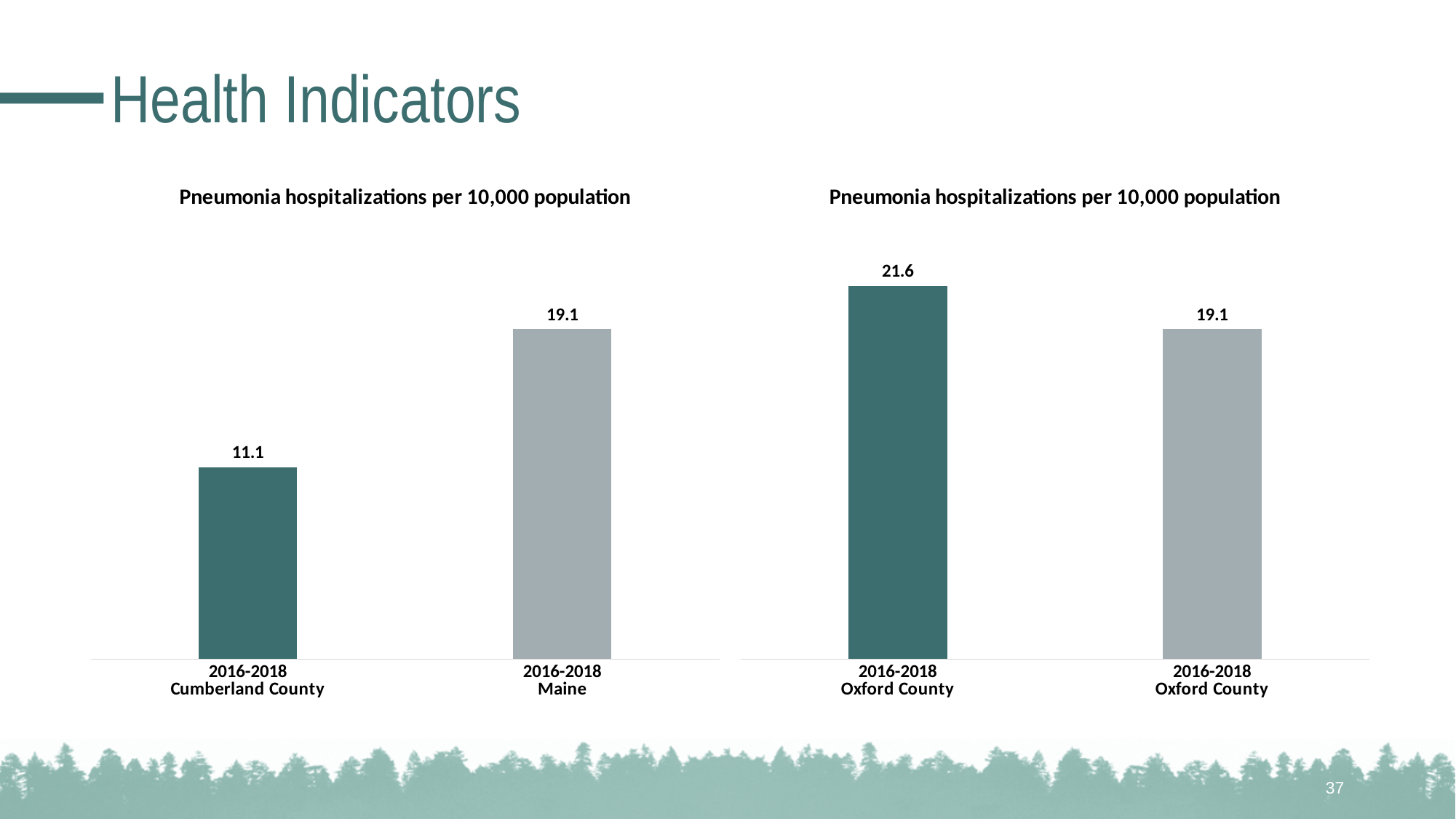
In the left chart, what is the value for 2016-2018 Cumberland County? 11.1 In the left chart, what is the difference between the Maine value and the Cumberland County value? 8.0 How many bars are plotted in the left chart? 2 In the right chart, what is the value of the dark teal bar on the left? 21.6 What is the title of the left chart? Pneumonia hospitalizations per 10,000 population In the left chart, which category has the lowest value? 2016-2018 Cumberland County In the right chart, what is the difference between the left bar (21.6) and the right bar (19.1)? 2.5 In the left chart, which category has the higher value, Cumberland County or Maine? Maine In the right chart, which bar is taller, the dark teal bar on the left or the gray bar on the right? the dark teal bar on the left What type of chart is the right chart? bar chart In the left chart, what is the value for 2016-2018 Maine? 19.1 In the right chart, what is the value of the gray bar on the right? 19.1